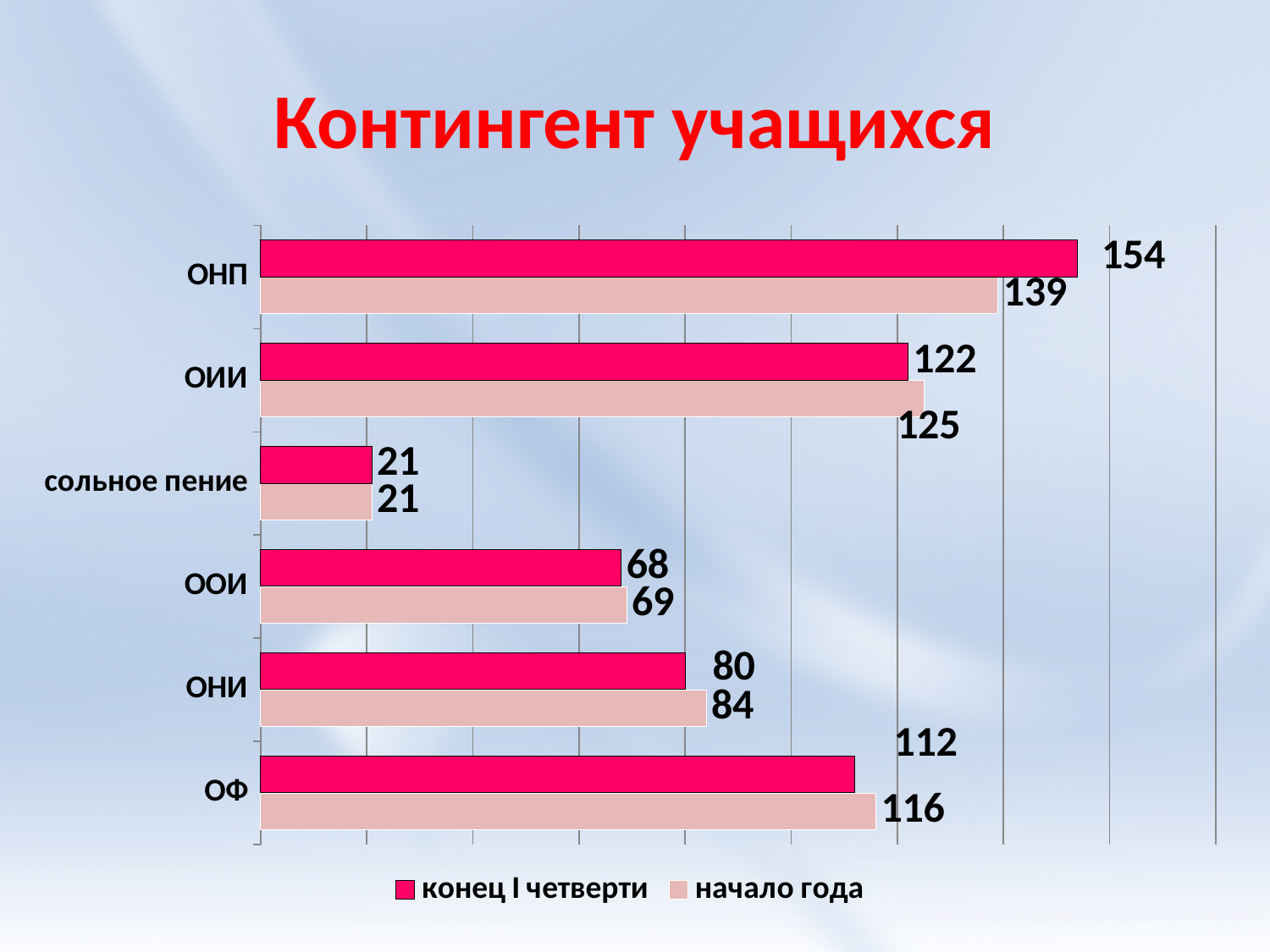
What kind of chart is shown on the slide? bar chart What is the value for ОФ in the начало года series? 116 How many series does the legend list? 2 Which category has the lowest value in the начало года series? сольное пение How many categories are shown on the chart? 6 What is the value for ОНП in the конец I четверти series? 154 What is the title of the chart? Контингент учащихся What is the difference between the конец I четверти and начало года values for ОНП? 15 Which category has the highest value in the конец I четверти series? ОНП Which is larger for ОИИ: the конец I четверти value or the начало года value? начало года What is the difference between the начало года and конец I четверти values for ОФ? 4 What is the value for ОНИ in the начало года series? 84